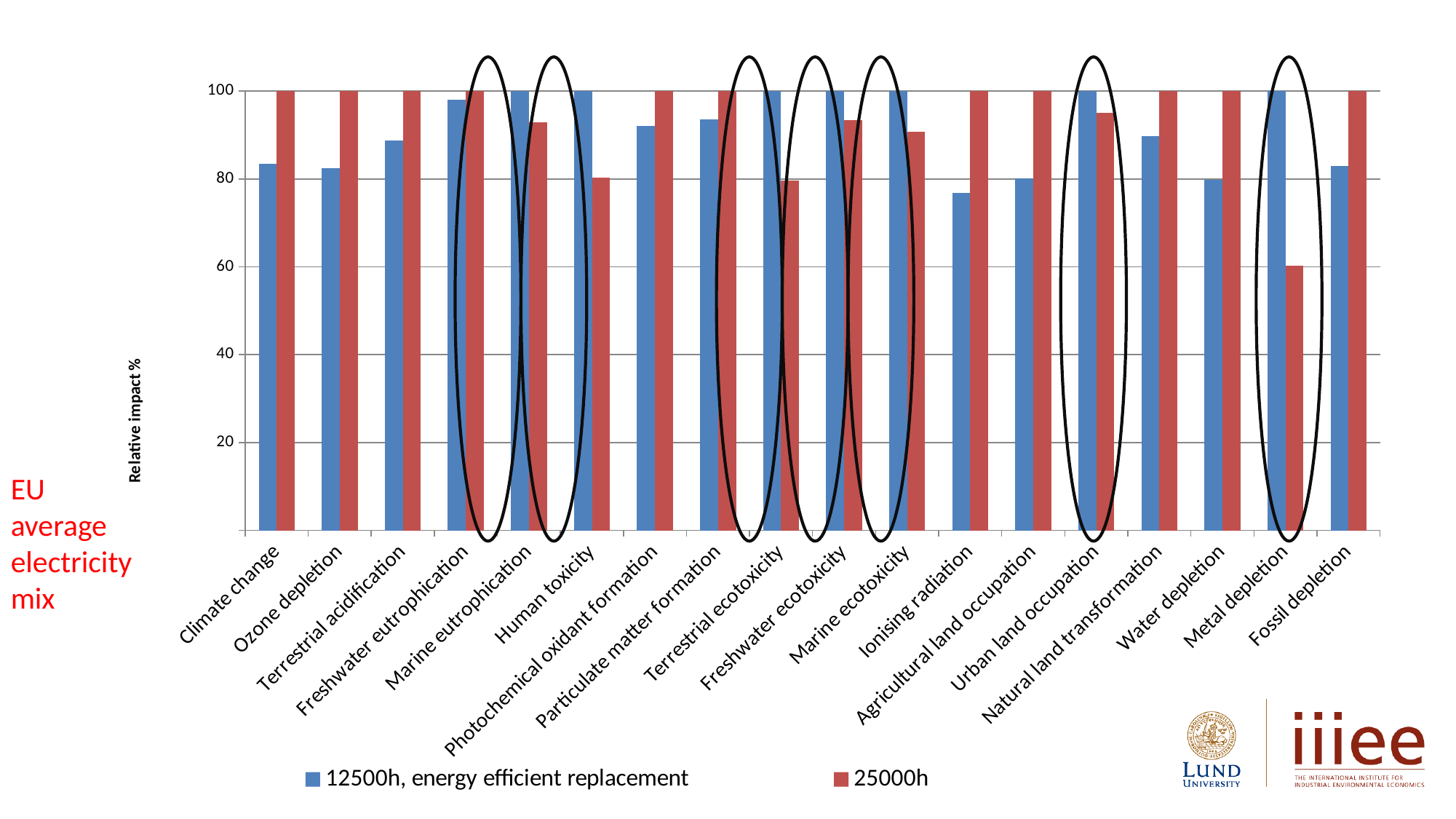
How many series does the legend list? 2 For Metal depletion, which series has the larger value: 12500h, energy efficient replacement or 25000h? 12500h, energy efficient replacement How many impact categories are shown on the x axis? 18 Is the value for the 25000h series for Metal depletion greater or less than 80? less What is the relative impact value for the 12500h, energy efficient replacement series for Urban land occupation? 100 Is the value for the 12500h, energy efficient replacement series for Ionising radiation greater or less than 80? less What is the relative impact value for the 25000h series for Climate change? 100 What is the label of the vertical axis? Relative impact % What kind of chart is shown on the slide? bar chart For Ionising radiation, which series has the larger value: 12500h, energy efficient replacement or 25000h? 25000h What is the relative impact value for the 12500h, energy efficient replacement series for Metal depletion? 100 Is the value for the 25000h series for Marine ecotoxicity greater or less than 80? greater